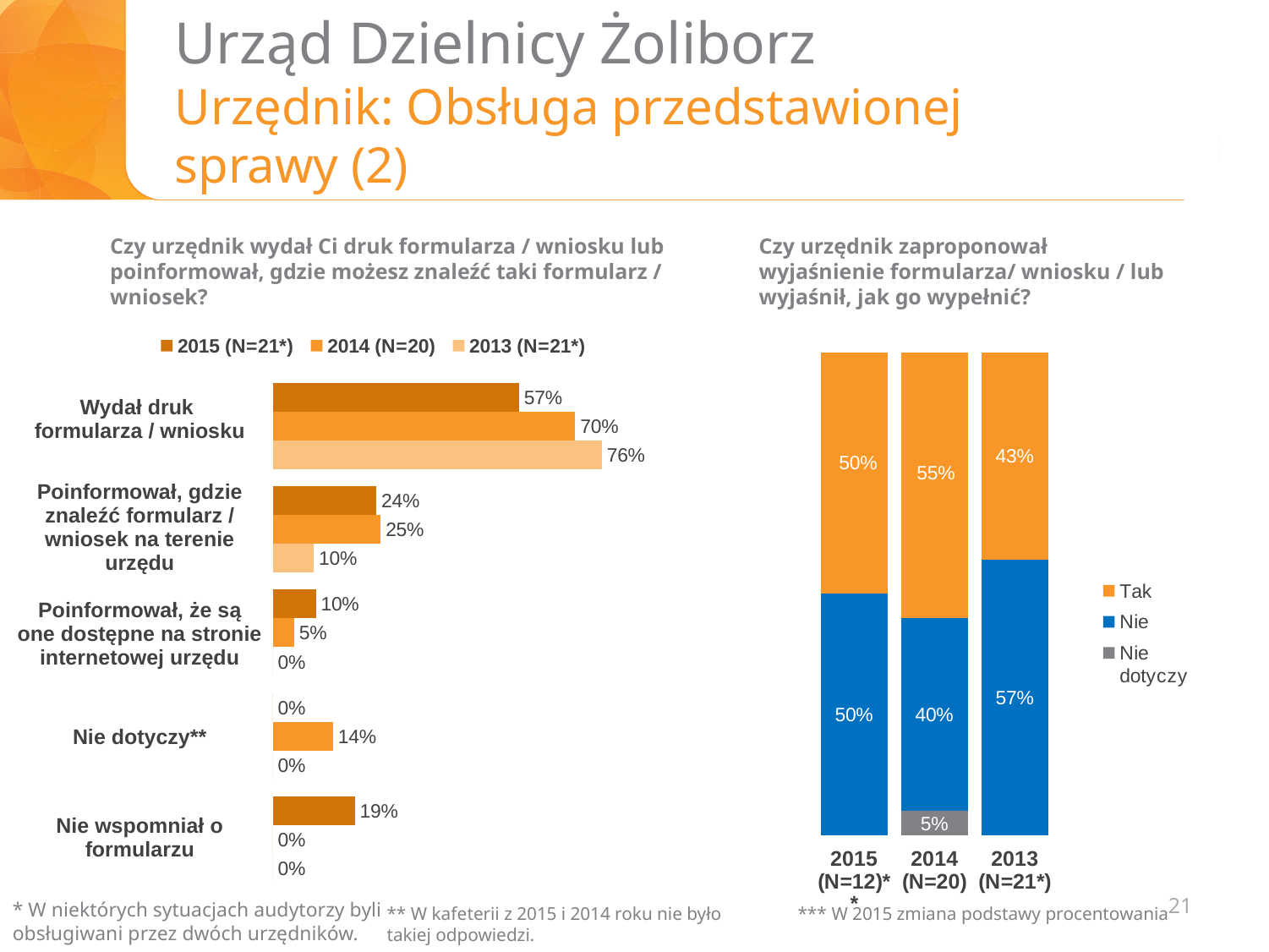
In the right chart, what is the "Tak" value for 2013 (N=21*)? 43% In the left chart, what is the difference between the 2013 and 2015 values for "Wydał druk formularza / wniosku"? 19 percentage points In the left chart, which category has the highest 2015 value? Wydał druk formularza / wniosku What type of chart is the left chart? Bar chart In the right chart, what is the total of the stacked bar for 2014 (N=20)? 100% How many series does the legend of the left chart list? 3 In the right chart, what is the "Nie" value for 2014 (N=20)? 40% In the left chart, which is larger for "Poinformował, gdzie znaleźć formularz / wniosek na terenie urzędu": the 2014 value or the 2013 value? 2014 In the left chart, what is the 2015 value for "Wydał druk formularza / wniosku"? 57% In the left chart, what is the 2013 value for "Wydał druk formularza / wniosku"? 76% In the left chart, what is the 2014 value for "Nie dotyczy**"? 14% In the right chart, which year has the highest "Tak" value? 2014 (N=20)